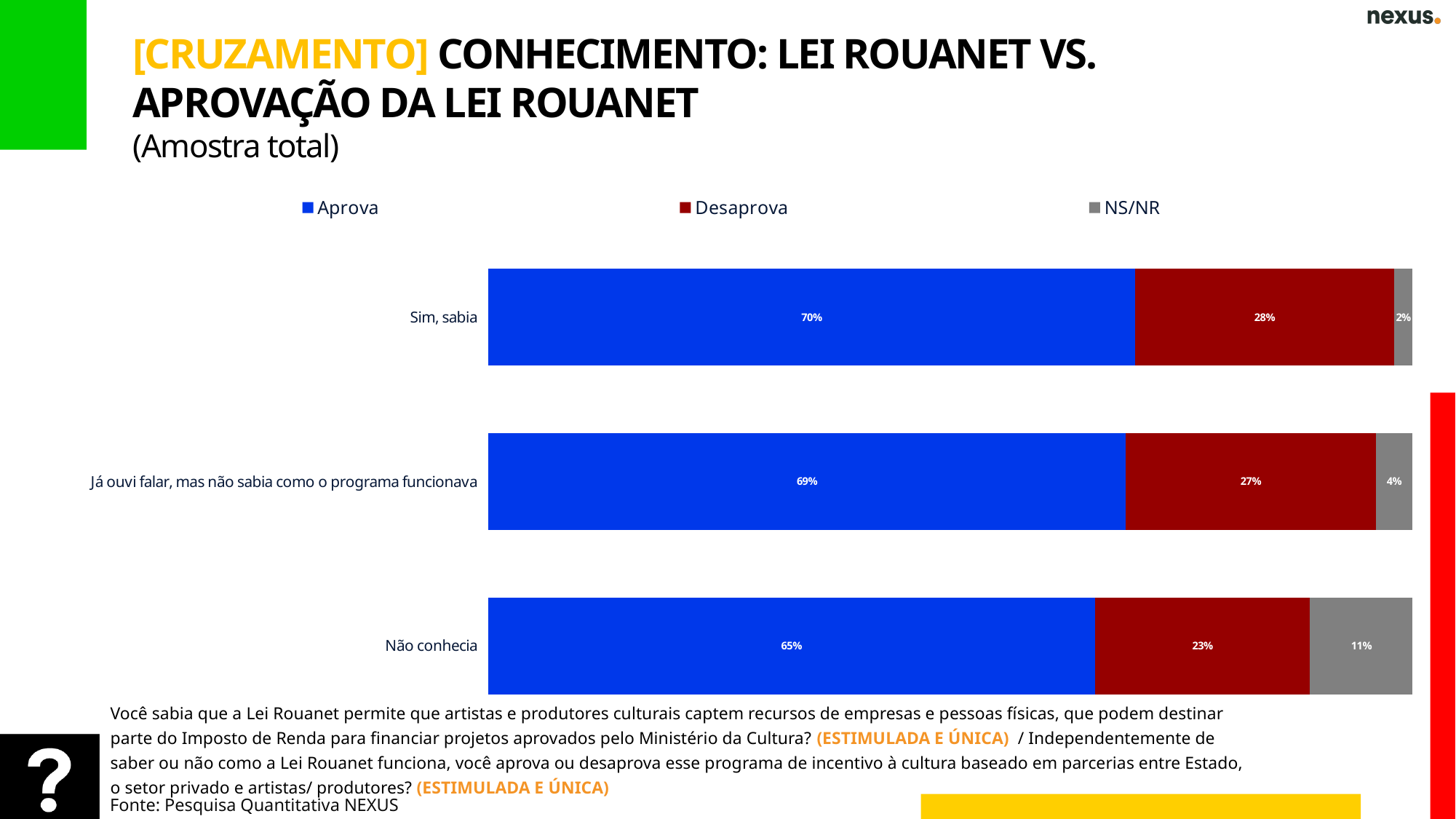
Which is larger: the Desaprova value for "Sim, sabia" or for "Não conhecia"? Sim, sabia What is the NS/NR value for "Já ouvi falar, mas não sabia como o programa funcionava"? 4% What percentage of respondents who answered "Sim, sabia" approve (Aprova) the Lei Rouanet? 70% What is the Desaprova value for the "Não conhecia" category? 23% Which category has the highest Aprova value? Sim, sabia How many categories are shown on the chart? 3 What kind of chart is shown on the slide? Stacked bar chart What is the difference between the Aprova values for "Sim, sabia" and "Não conhecia"? 5% Which colour represents the Desaprova series in the legend? Dark red How many series does the legend list? 3 What is the total of the stacked bar for "Não conhecia"? 99% Which category has the lowest NS/NR value? Sim, sabia